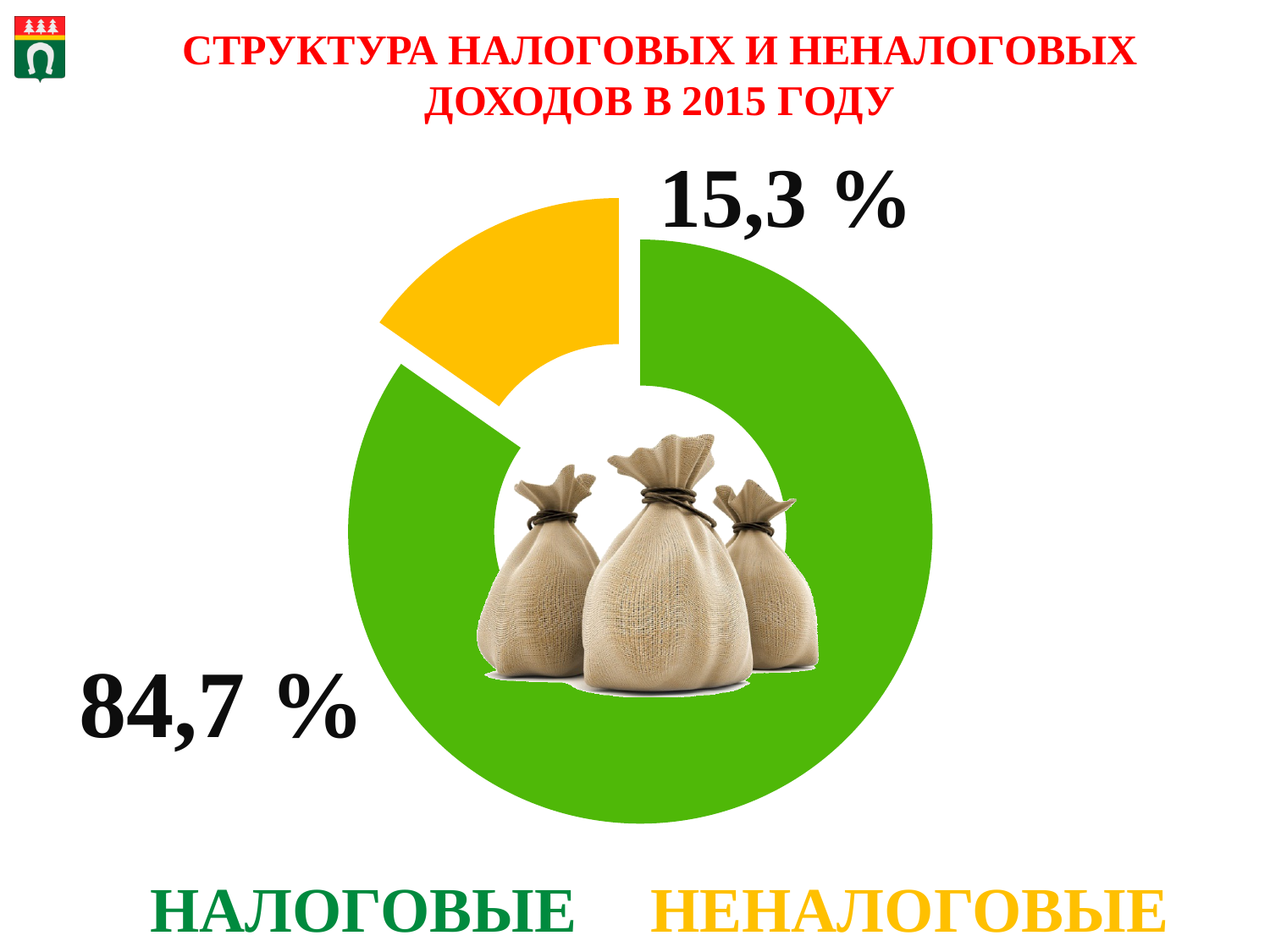
Which year does the chart refer to? 2015 What share of the pie does the yellow slice represent? 15,3 % By how many percentage points does the share of НАЛОГОВЫЕ exceed the share of НЕНАЛОГОВЫЕ? 69,4 What kind of chart is shown on the slide? Pie (donut) chart What colour represents НАЛОГОВЫЕ in the chart? Green Which category has the largest share of the chart? НАЛОГОВЫЕ What is the title of the slide? СТРУКТУРА НАЛОГОВЫХ И НЕНАЛОГОВЫХ ДОХОДОВ В 2015 ГОДУ Which is larger: the share of НАЛОГОВЫЕ or the share of НЕНАЛОГОВЫЕ? НАЛОГОВЫЕ What share of revenues is shown for НАЛОГОВЫЕ (tax revenues)? 84,7 % Which category has the smallest share of the chart? НЕНАЛОГОВЫЕ How many categories are shown in the chart? 2 What share of revenues is shown for НЕНАЛОГОВЫЕ (non-tax revenues)? 15,3 %